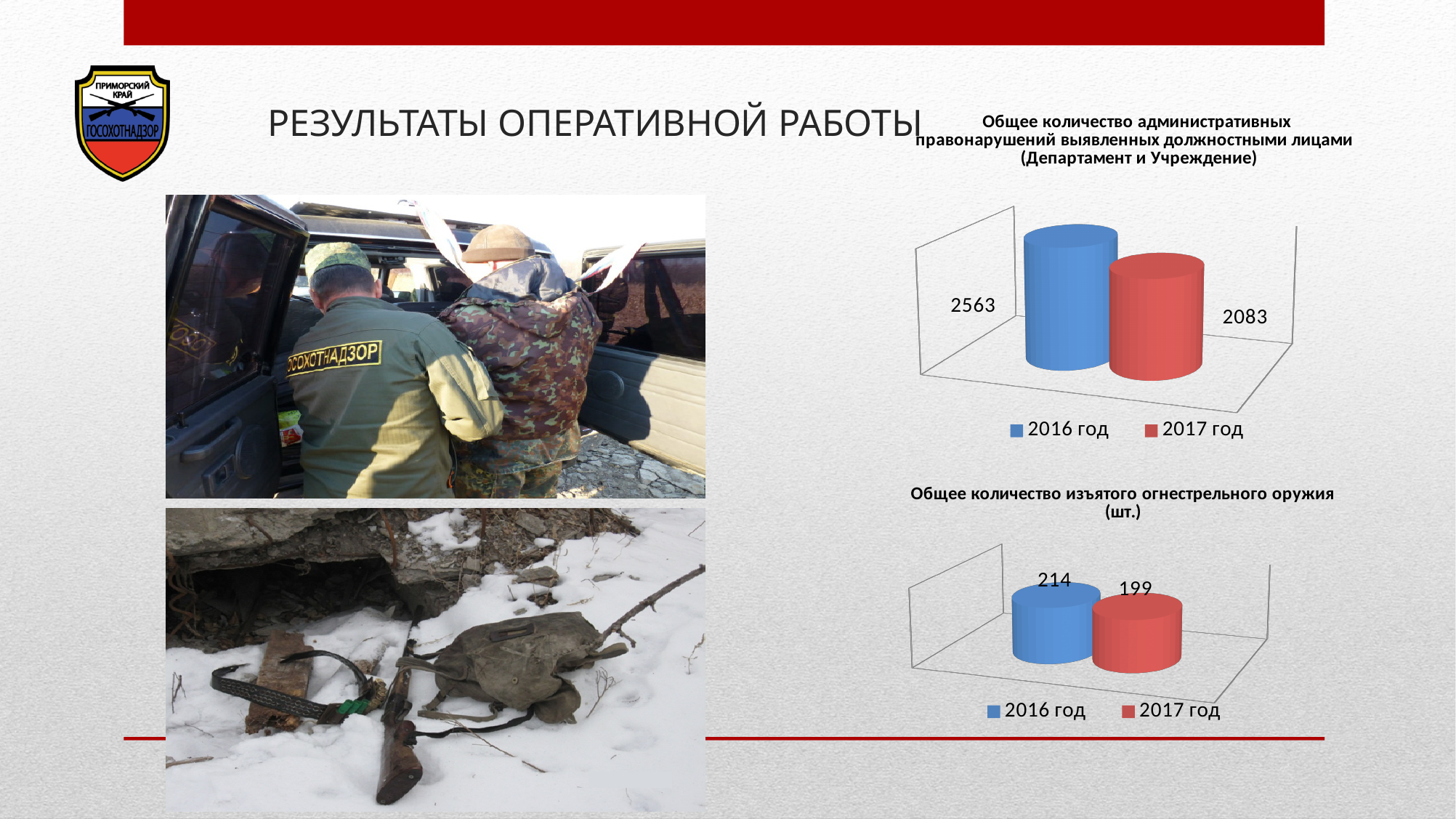
In the bottom chart (seized firearms), is the value for 2016 год larger or smaller than the value for 2017 год? larger In the top chart (administrative violations), what is the value for 2016 год? 2563 How many series does the legend of the top chart (administrative violations) list? 2 In the top chart (administrative violations), what is the difference between the 2016 and 2017 values? 480 What kind of chart is the bottom chart (seized firearms)? bar chart In the top chart (administrative violations), what is the value for 2017 год? 2083 In the top chart (administrative violations), which colour represents 2017 год? red In the bottom chart (seized firearms), what is the difference between the 2016 and 2017 values? 15 In the bottom chart (seized firearms), what is the value for 2017 год? 199 In the bottom chart (seized firearms), which year has the lower value? 2017 год In the top chart (administrative violations), which year has the higher value? 2016 год In the bottom chart (seized firearms), what is the value for 2016 год? 214